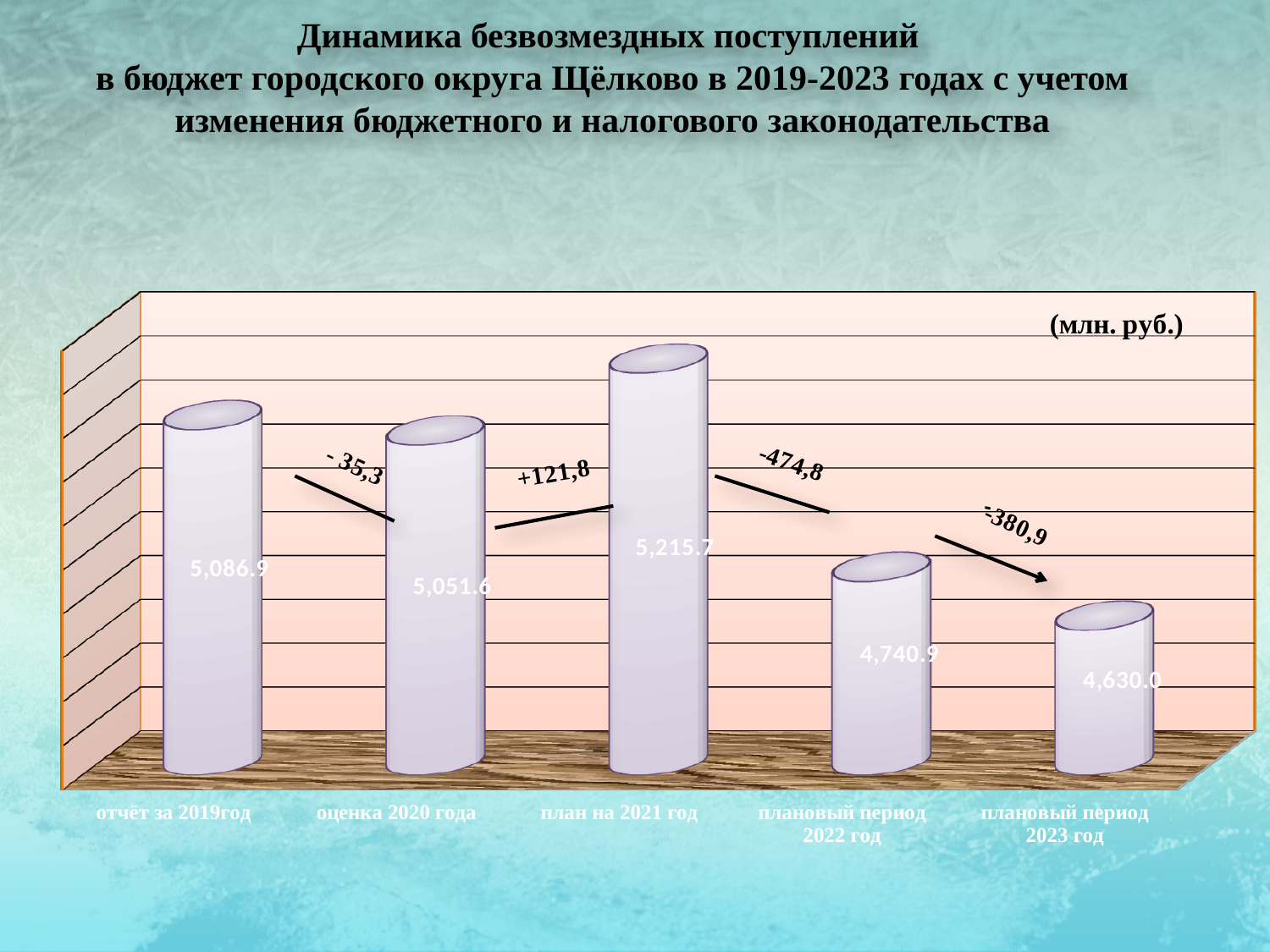
What is the value for «плановый период 2022 год»? 4,740.9 How many categories are shown in the chart? 5 Which category has the lowest value? плановый период 2023 год What is the value for «отчёт за 2019 год»? 5,086.9 Which is larger: the value for «план на 2021 год» or the value for «плановый период 2022 год»? план на 2021 год What unit of measurement is indicated on the chart? млн. руб. What is the difference between the values for «план на 2021 год» and «плановый период 2022 год»? 474.8 Which category has the highest value? план на 2021 год What is the difference between the values for «отчёт за 2019 год» and «оценка 2020 года»? 35.3 What is the value for «план на 2021 год»? 5,215.7 What is the value for «оценка 2020 года»? 5,051.6 What is the value for «плановый период 2023 год»? 4,630.0